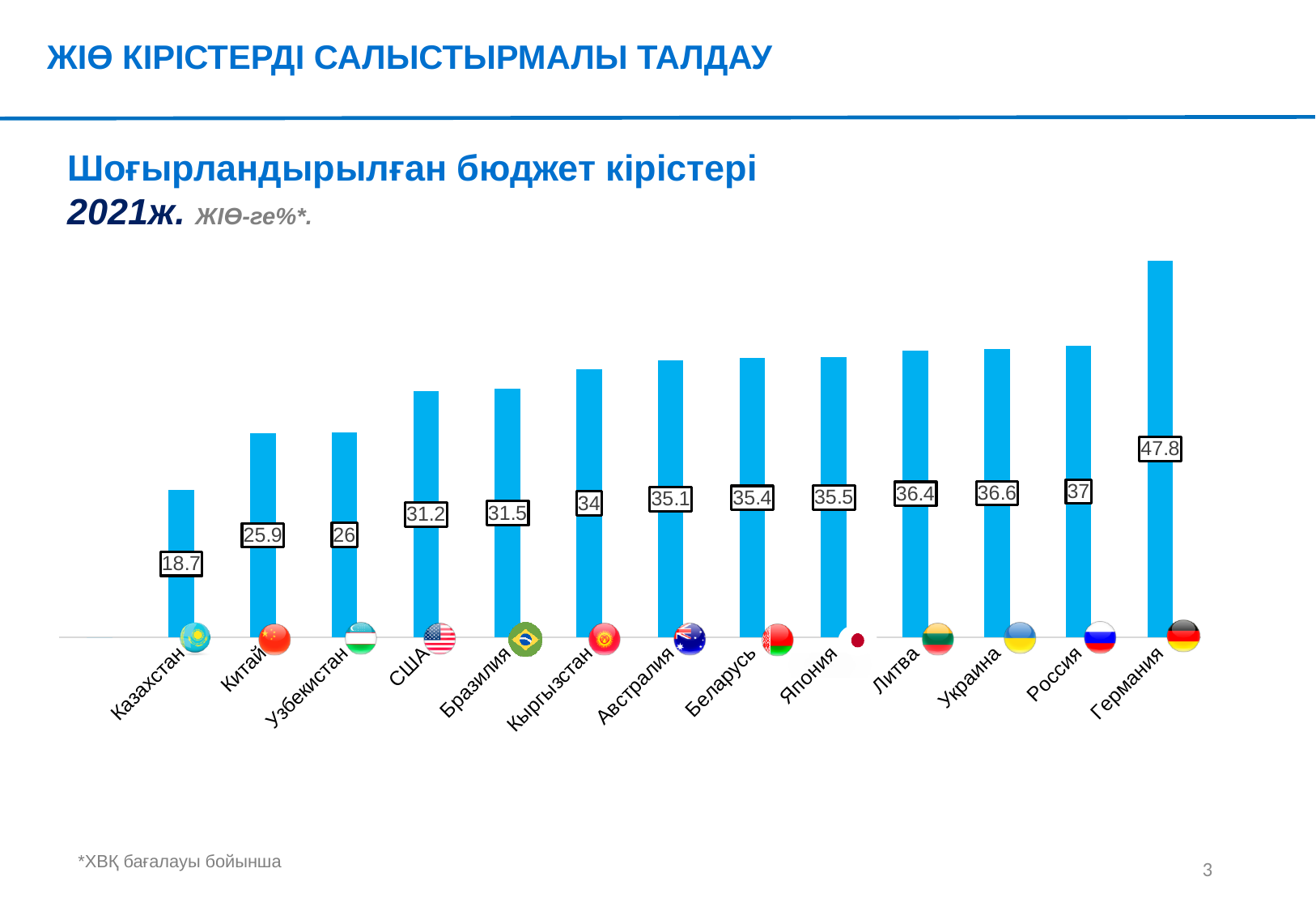
What is the value for Германия? 47.8 Which country has the lowest value? Казахстан Which is larger, the value for Бразилия or the value for Литва? Литва What kind of chart is shown on the slide? Bar chart How many countries are shown in the chart? 13 What is the difference between the values for США and Китай? 5.3 What is the value for Казахстан? 18.7 Which country has the highest value? Германия What is the value for Кыргызстан? 34 Do the values rise or fall from left to right along the x axis? Rise What is the value for Россия? 37 What is the difference between the values for Германия and Казахстан? 29.1